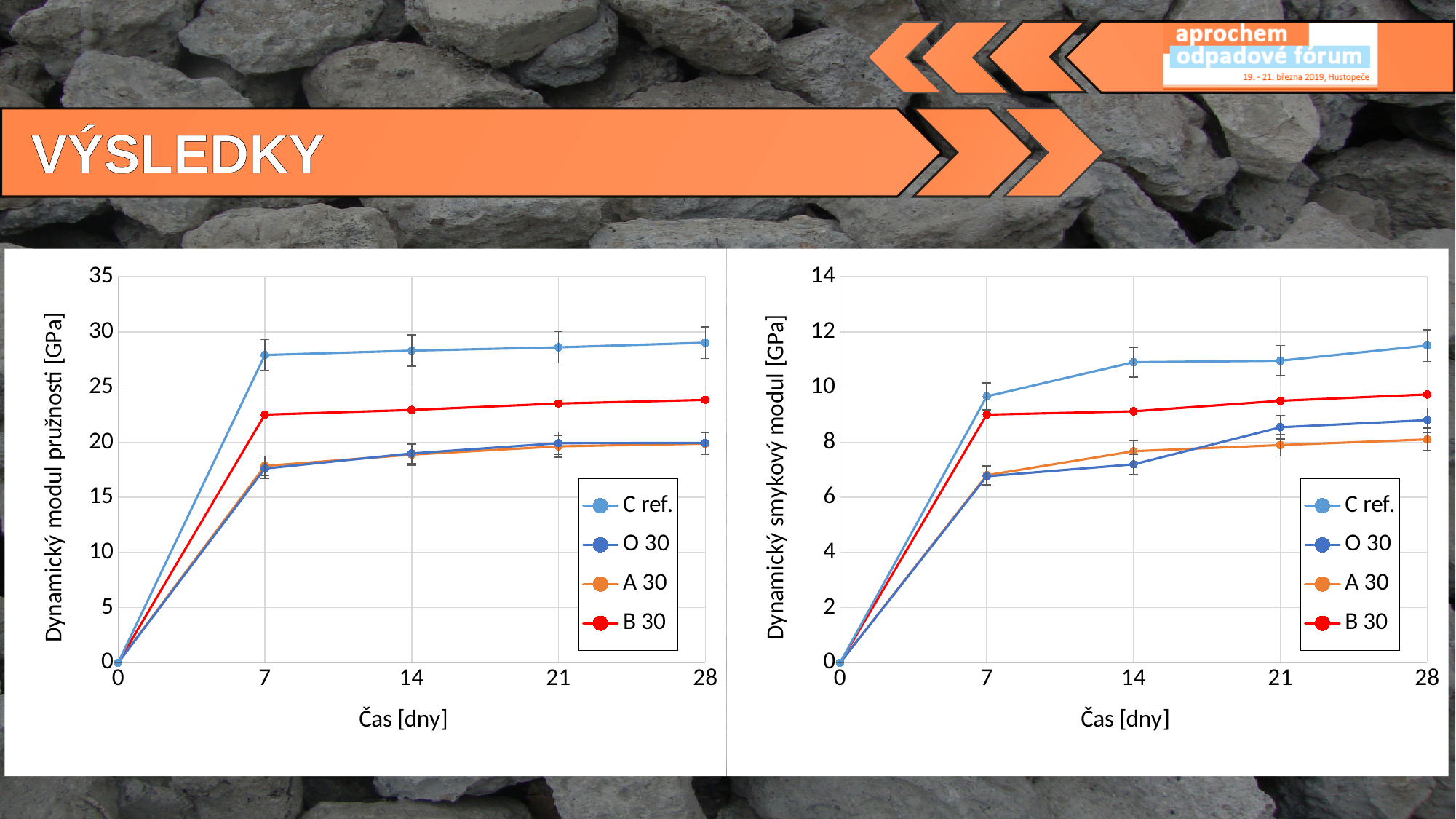
In the right chart (Dynamický smykový modul), does the C ref. series rise or fall from 0 to 28 days? rise What is the x-axis title of the right chart (Dynamický smykový modul)? Čas [dny] In the left chart (Dynamický modul pružnosti), is the value for B 30 at 28 days greater or less than 25? less In the right chart (Dynamický smykový modul), which series has the highest value at 28 days? C ref. In the right chart (Dynamický smykový modul), is the value for C ref. at 28 days greater or less than 10? greater In the right chart (Dynamický smykový modul), is the value for B 30 at 7 days greater or less than 10? less How many time points are plotted along the x axis of the left chart (Dynamický modul pružnosti)? 5 In the left chart (Dynamický modul pružnosti), which series has the highest value at 28 days? C ref. What kind of chart is the left chart (Dynamický modul pružnosti)? line chart In the left chart (Dynamický modul pružnosti), which is larger at 28 days: B 30 or O 30? B 30 How many series does the legend of the right chart (Dynamický smykový modul) list? 4